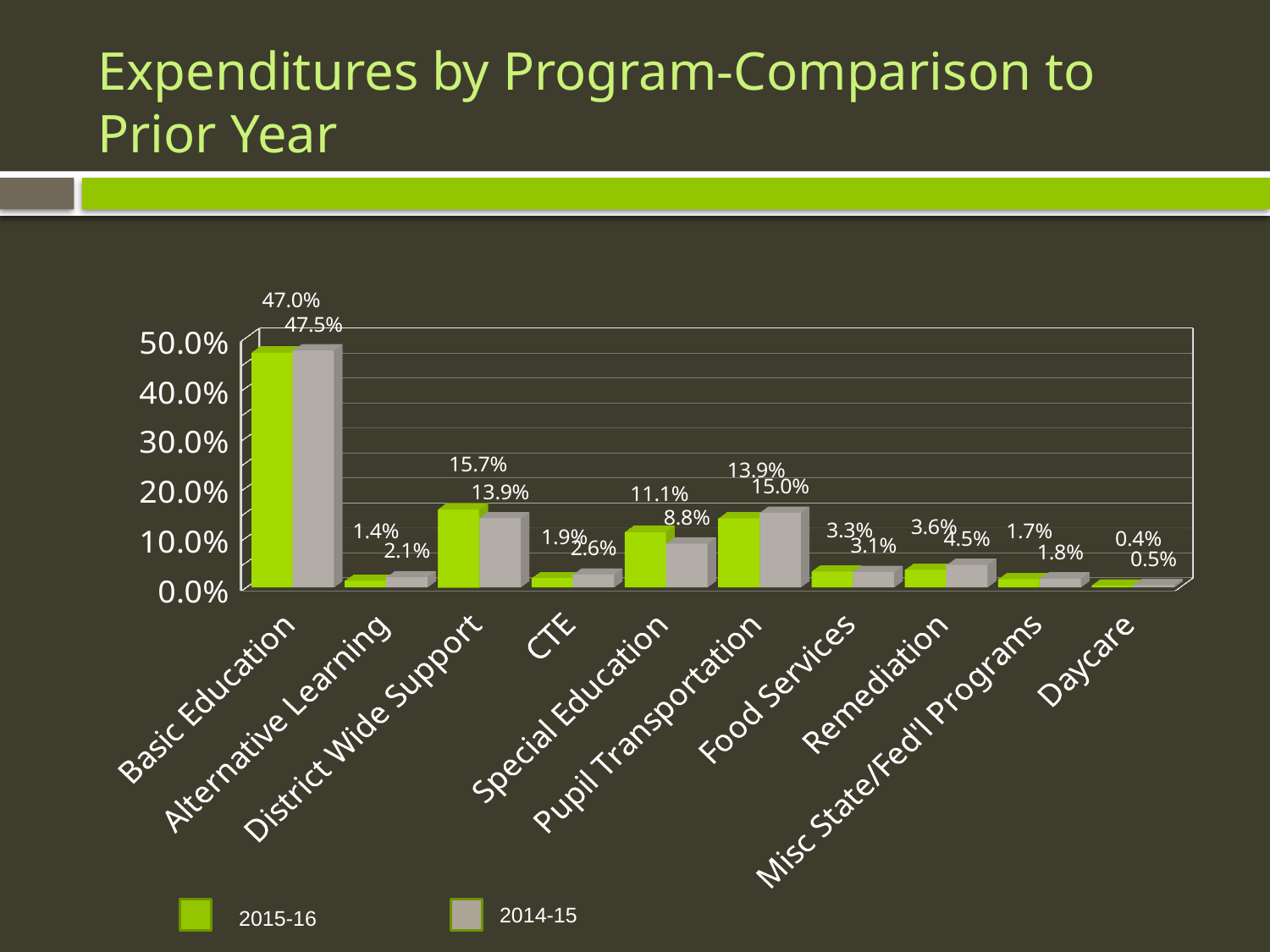
Which program has the highest 2015-16 expenditure share? Basic Education What kind of chart is shown on the slide? Bar chart Is the 2014-15 value for Pupil Transportation greater or less than 10.0%? greater What is the 2015-16 value for Basic Education? 47.0% How many series does the legend list? 2 What is the 2014-15 value for Special Education? 8.8% What is the title of the chart on the slide? Expenditures by Program-Comparison to Prior Year For Remediation, which year has the larger value, 2015-16 or 2014-15? 2014-15 What is the difference between the 2015-16 and 2014-15 values for District Wide Support? 1.8% What is the 2015-16 value for Pupil Transportation? 13.9% Which program has the lowest 2014-15 expenditure share? Daycare How many program categories are shown on the x axis? 10